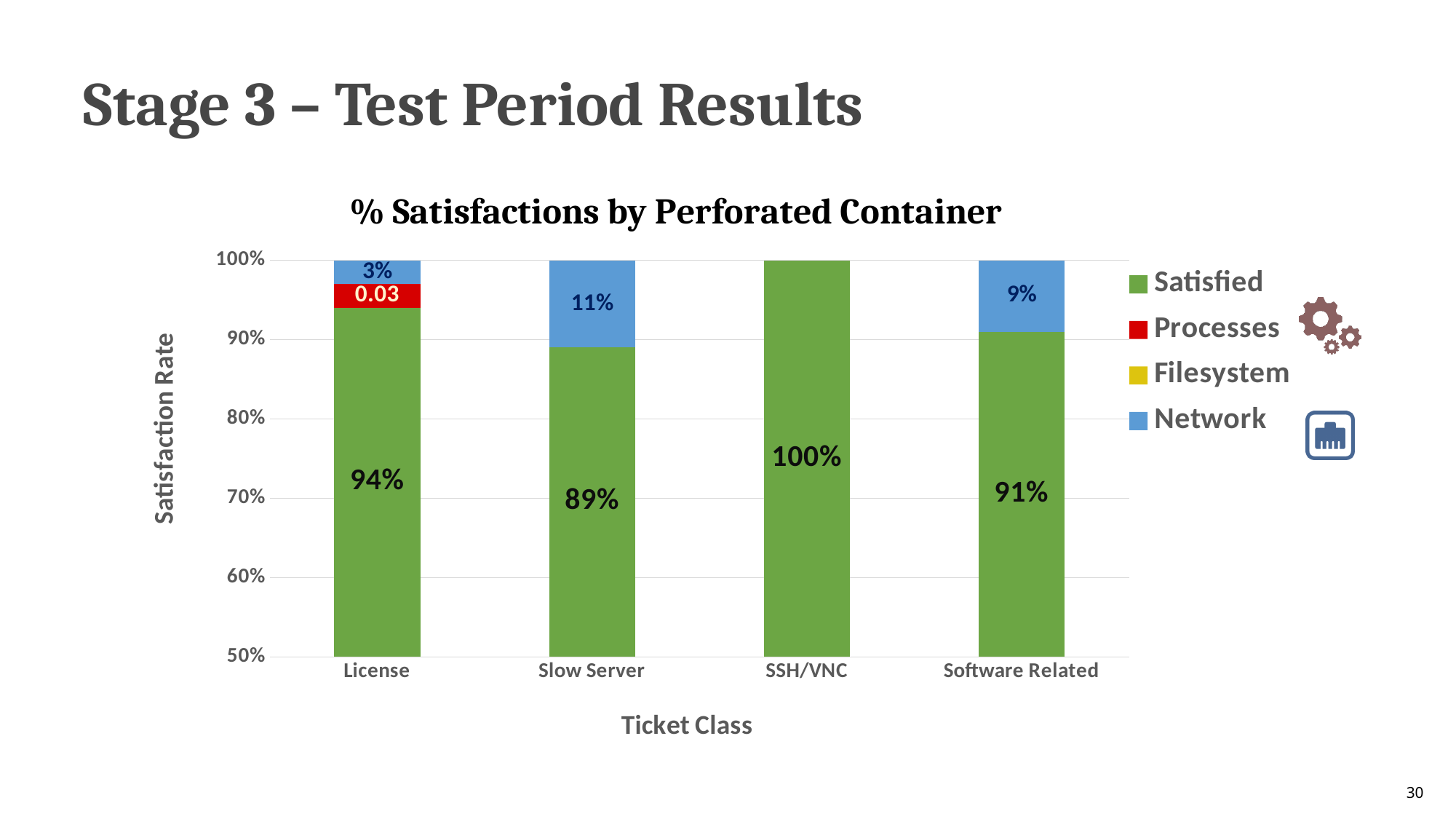
What is the Satisfied value for SSH/VNC? 100% How many series does the legend list? 4 Which is larger, the Network value for Slow Server or for Software Related? Slow Server Which ticket class has the highest Satisfied value? SSH/VNC What is the difference between the Satisfied values for License and Slow Server? 5% What kind of chart is shown on the slide? Stacked bar chart What is the Network value for the Slow Server ticket class? 11% Which ticket class has the lowest Satisfied value? Slow Server How many ticket classes are shown on the x axis? 4 What is the Satisfied value for the License ticket class? 94% What is the Network value for the Software Related ticket class? 9% What label is shown on the Processes segment of the License bar? 0.03